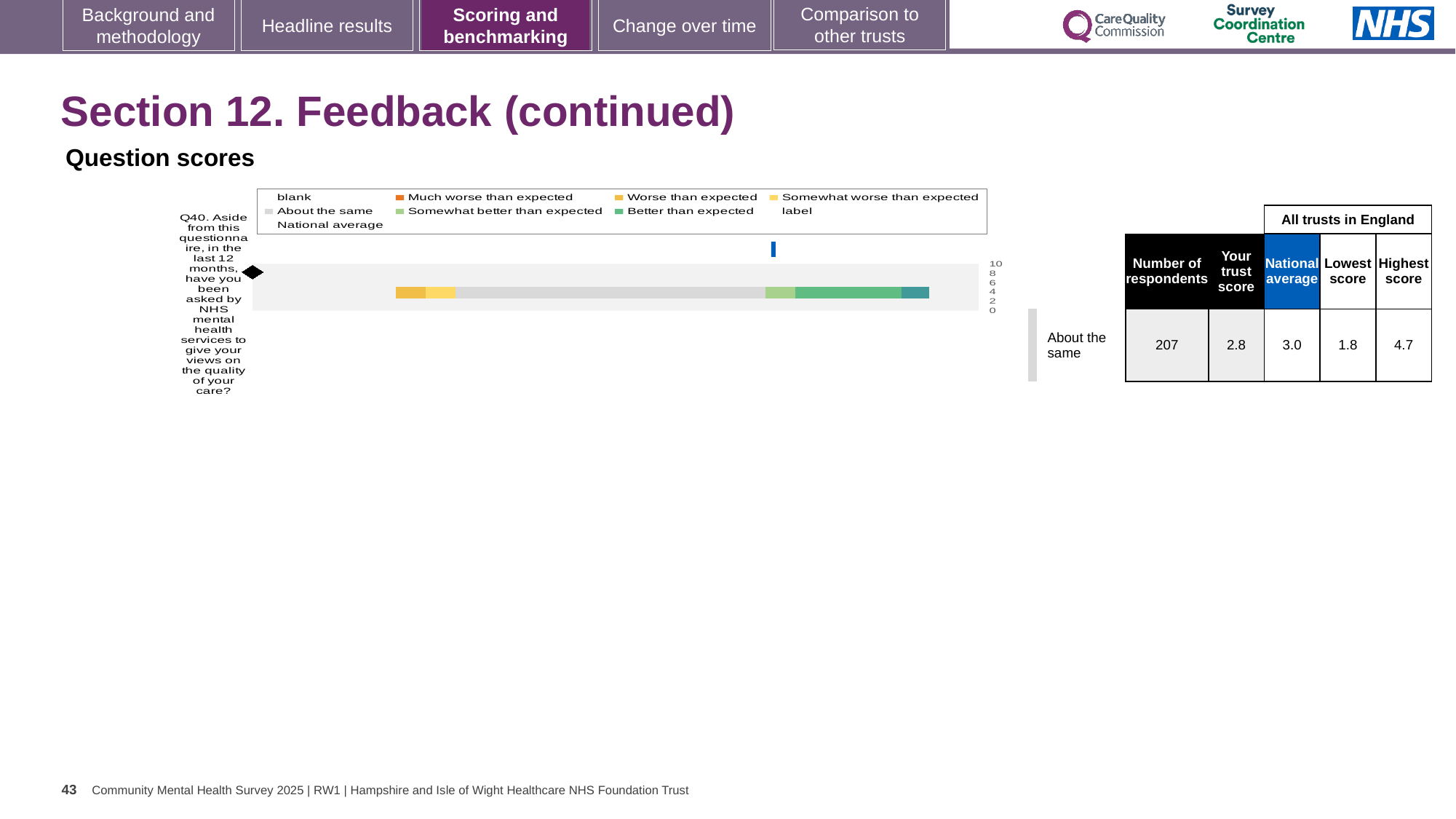
What kind of chart is used to show the question score for Q40? bar chart What is the trust's score for Q40 shown alongside the chart? 2.8 Which question number is shown on the chart? Q40 Which benchmarking category is the trust's Q40 score placed in? About the same Which is larger for Q40, the trust's score or the national average? National average How many questions are plotted on the chart? 1 How many respondents answered Q40? 207 What is the lowest score among all trusts in England for Q40? 1.8 What is the difference between the highest and lowest scores for Q40 across all trusts in England? 2.9 What is the national average score for Q40? 3.0 What is the highest score among all trusts in England for Q40? 4.7 By how much does the national average exceed the trust's score for Q40? 0.2